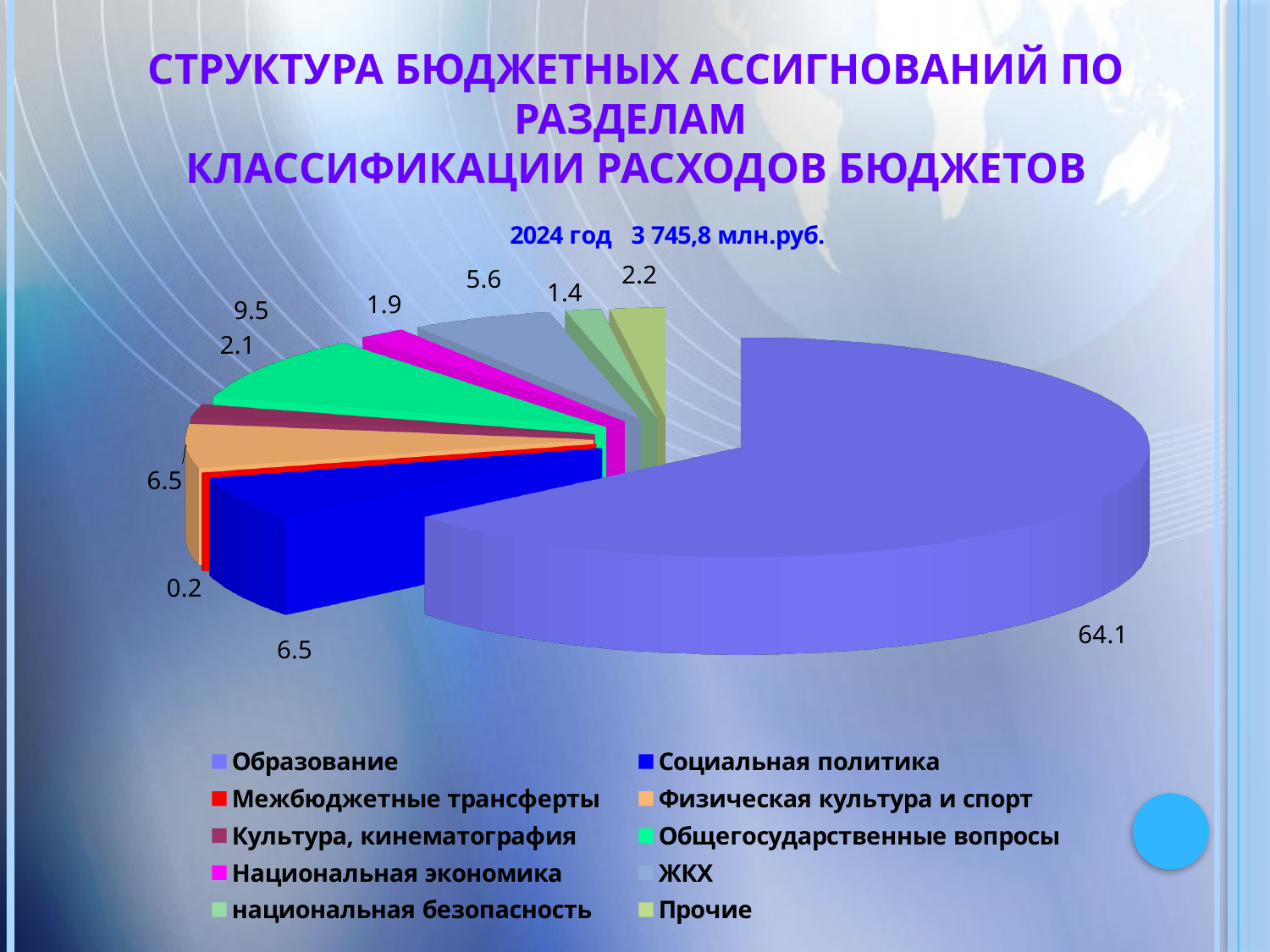
What total amount for 2024 is stated above the pie chart? 3 745,8 млн.руб. What value is shown for Межбюджетные трансферты? 0.2 How many categories does the legend of the pie chart list? 10 Which category has the smallest slice of the pie? Межбюджетные трансферты What value is shown for Образование? 64.1 Which is larger, the value for ЖКХ or the value for Национальная экономика? ЖКХ What value is shown for ЖКХ? 5.6 What kind of chart is shown on the slide? pie chart What value is shown for Прочие? 2.2 What is the difference between the values for Образование and Общегосударственные вопросы? 54.6 Which category has the largest slice of the pie? Образование What value is shown for Общегосударственные вопросы? 9.5